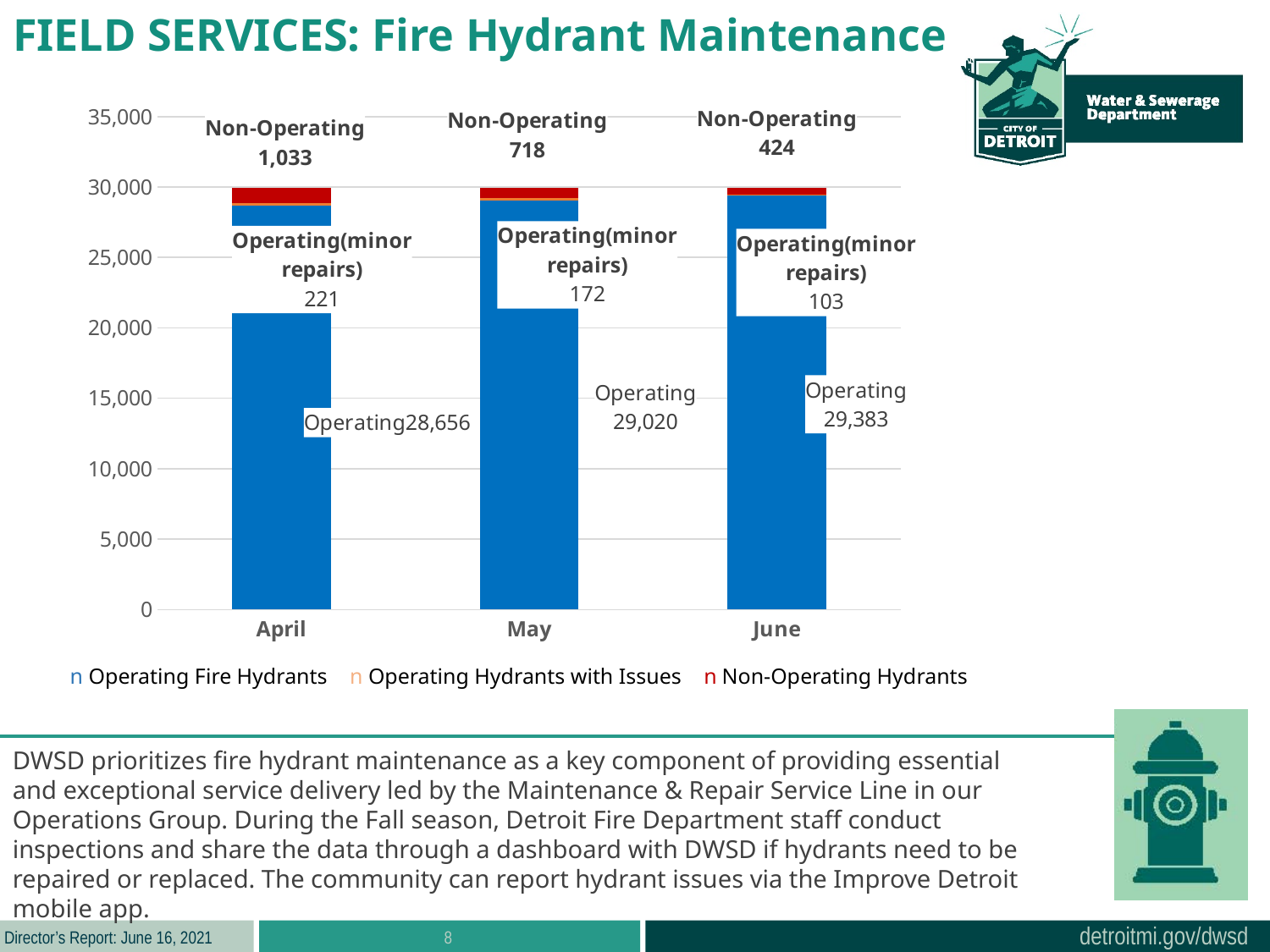
What is the number of Operating (minor repairs) hydrants in June? 103 What is the number of Operating fire hydrants in April? 28,656 How many months are shown on the x axis of the chart? 3 What kind of chart is shown on the slide? Stacked bar chart What is the total of the stacked bar for April? 29,910 Do the Operating fire hydrant values rise or fall from April to June? Rise What is the number of Non-Operating hydrants in May? 718 Which month has the highest number of Non-Operating hydrants? April What is the difference between the Non-Operating hydrants in April and in June? 609 Which is larger, the number of Operating hydrants in May or in June? June How many series does the chart legend list? 3 Which month has the lowest number of Operating (minor repairs) hydrants? June